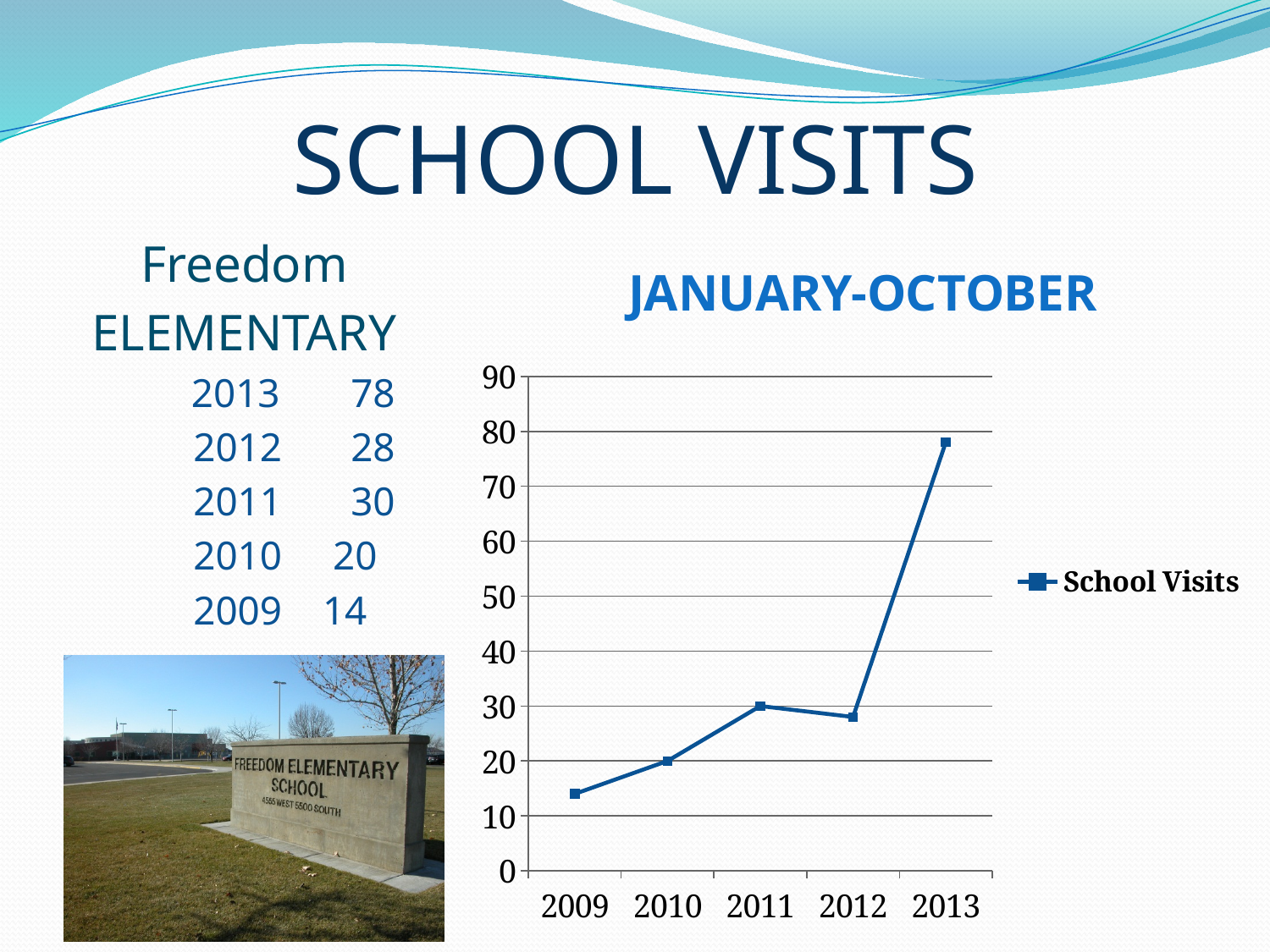
Is the value for 2013 greater or less than 70? greater Which year has the highest number of School Visits? 2013 What kind of chart is shown on the slide? line chart What is the value of School Visits for 2009? 14 Which year has more School Visits, 2011 or 2012? 2011 How many series does the chart's legend list? 1 How many years are plotted on the x axis of the chart? 5 What is the name of the series shown in the chart's legend? School Visits What is the difference in School Visits between 2013 and 2012? 50 Which year has the lowest number of School Visits? 2009 What is the value of School Visits for 2011? 30 What is the value of School Visits for 2013? 78